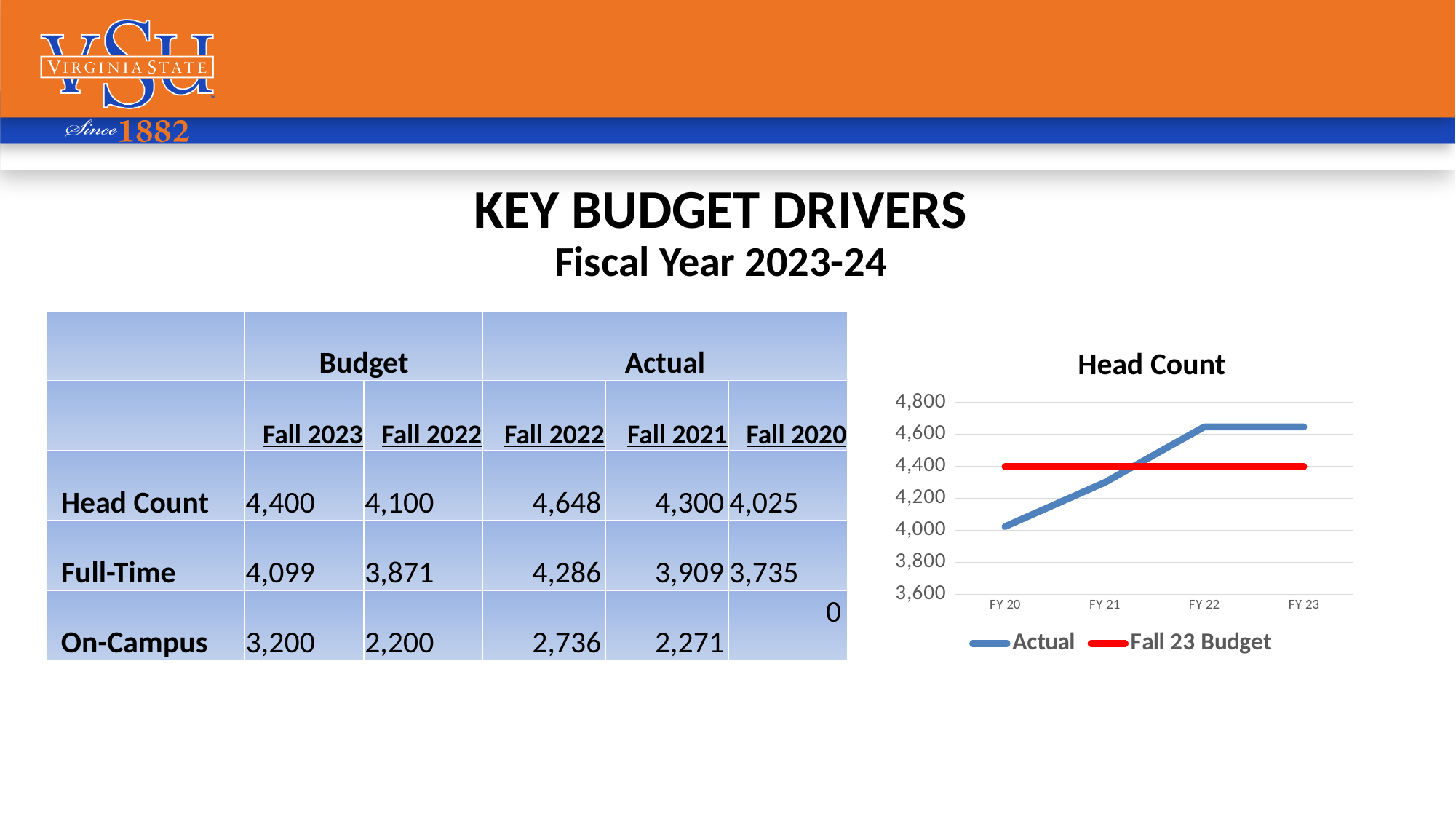
How many fiscal years are shown on the x axis of the Head Count chart? 4 In the Head Count chart, which series is higher at FY 23, Actual or Fall 23 Budget? Actual In the Head Count chart, is the Actual value for FY 20 greater or less than 4,200? less How many series does the legend of the Head Count chart list? 2 In the Head Count chart, is the Actual value for FY 21 greater or less than 4,400? less What is the title of the line chart on the slide? Head Count In the Head Count chart, is the Actual value for FY 22 greater or less than 4,400? greater What kind of chart is the Head Count chart? line chart In the Head Count chart, which series is higher at FY 20, Actual or Fall 23 Budget? Fall 23 Budget In the Head Count chart, which fiscal year has the lowest Actual value? FY 20 In the Head Count chart, does the Actual series rise or fall from FY 20 to FY 22? rise In the Head Count chart, what colour is the Fall 23 Budget line? red